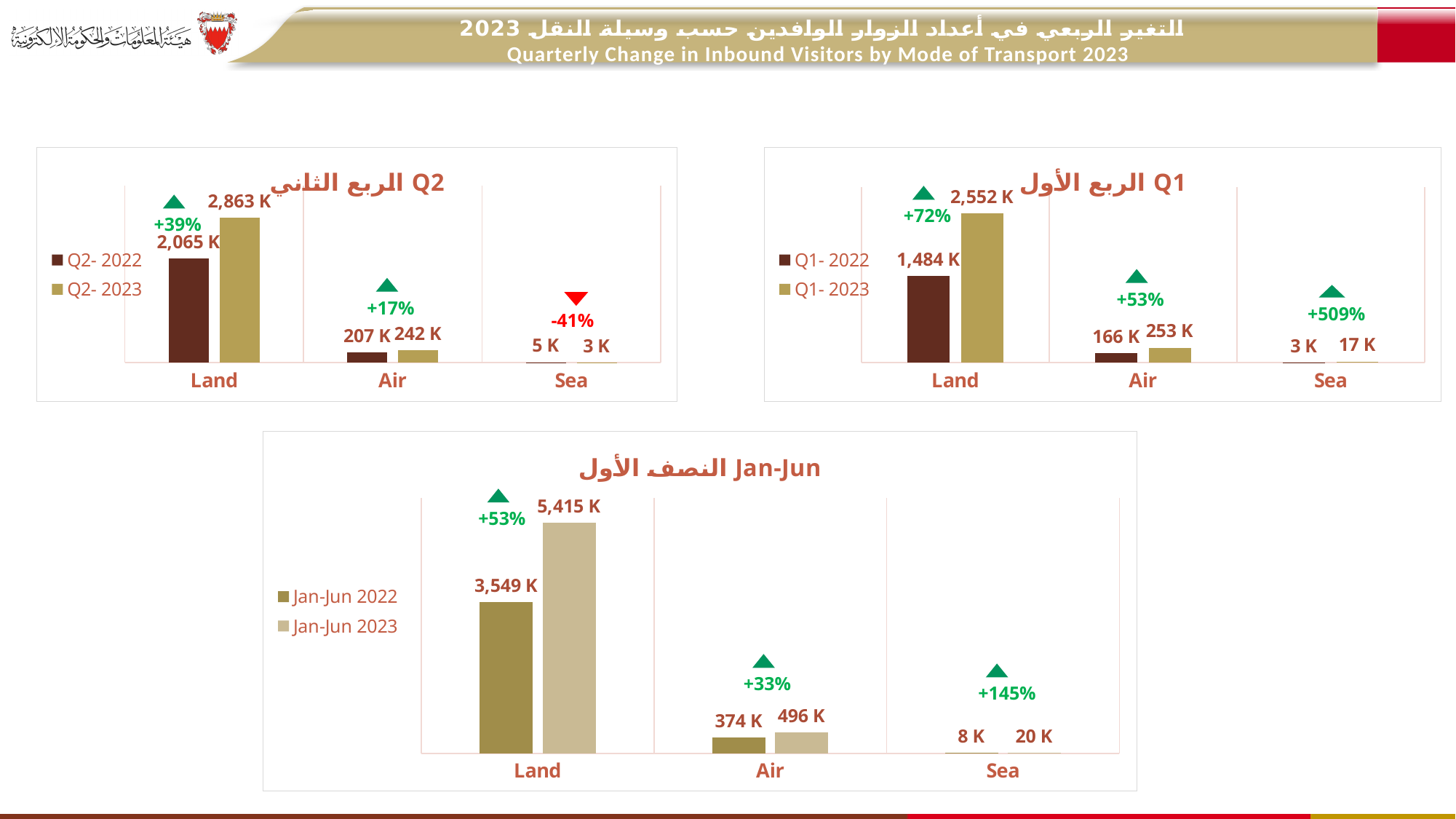
In the Q2 chart (top left), what is the difference between the Q2-2023 and Q2-2022 values for Air? 35 K In the Q1 chart (top right), how many series does the legend list? 2 In the Q1 chart (top right), what percentage change is shown for Sea? +509% In the Q1 chart (top right), which mode of transport has the highest value in Q1-2023? Land In the Jan-Jun chart (bottom), what is the difference between the Jan-Jun 2023 and Jan-Jun 2022 values for Land? 1,866 K What kind of chart is the Jan-Jun chart (bottom)? Bar chart In the Jan-Jun chart (bottom), what is the value for Air in Jan-Jun 2023? 496 K In the Q2 chart (top left), which mode of transport shows a decrease from 2022 to 2023? Sea In the Jan-Jun chart (bottom), which mode of transport has the lowest value in Jan-Jun 2022? Sea In the Q1 chart (top right), what is the value for Land in Q1-2022? 1,484 K In the Q2 chart (top left), what is the value for Land in Q2-2023? 2,863 K In the Q2 chart (top left), what is the value for Sea in Q2-2022? 5 K